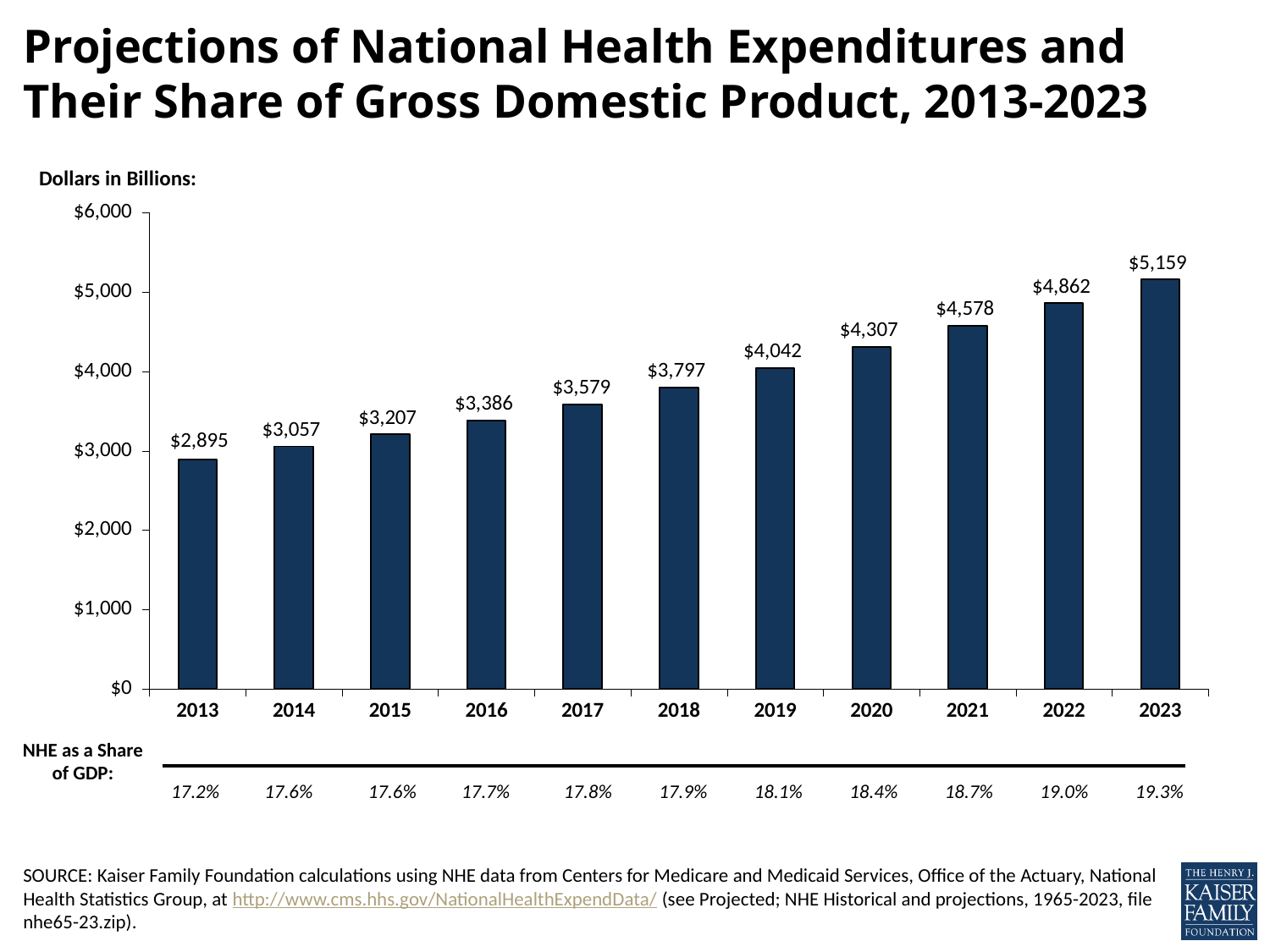
How many years are shown on the chart? 11 What is the projected national health expenditure for 2013? $2,895 Is the projected expenditure for 2021 greater or less than $4,000? greater What kind of chart is shown on the slide? bar chart What is the projected national health expenditure for 2020? $4,307 What unit is stated for the values on the chart? Dollars in Billions Which year has the lowest projected national health expenditure? 2013 Do the projected expenditures rise or fall from 2013 to 2023? rise What is NHE as a share of GDP in 2023? 19.3% What is the difference between the projected expenditures for 2023 and 2013? $2,264 Which year has the highest projected national health expenditure? 2023 Which year has the larger projected expenditure, 2017 or 2019? 2019